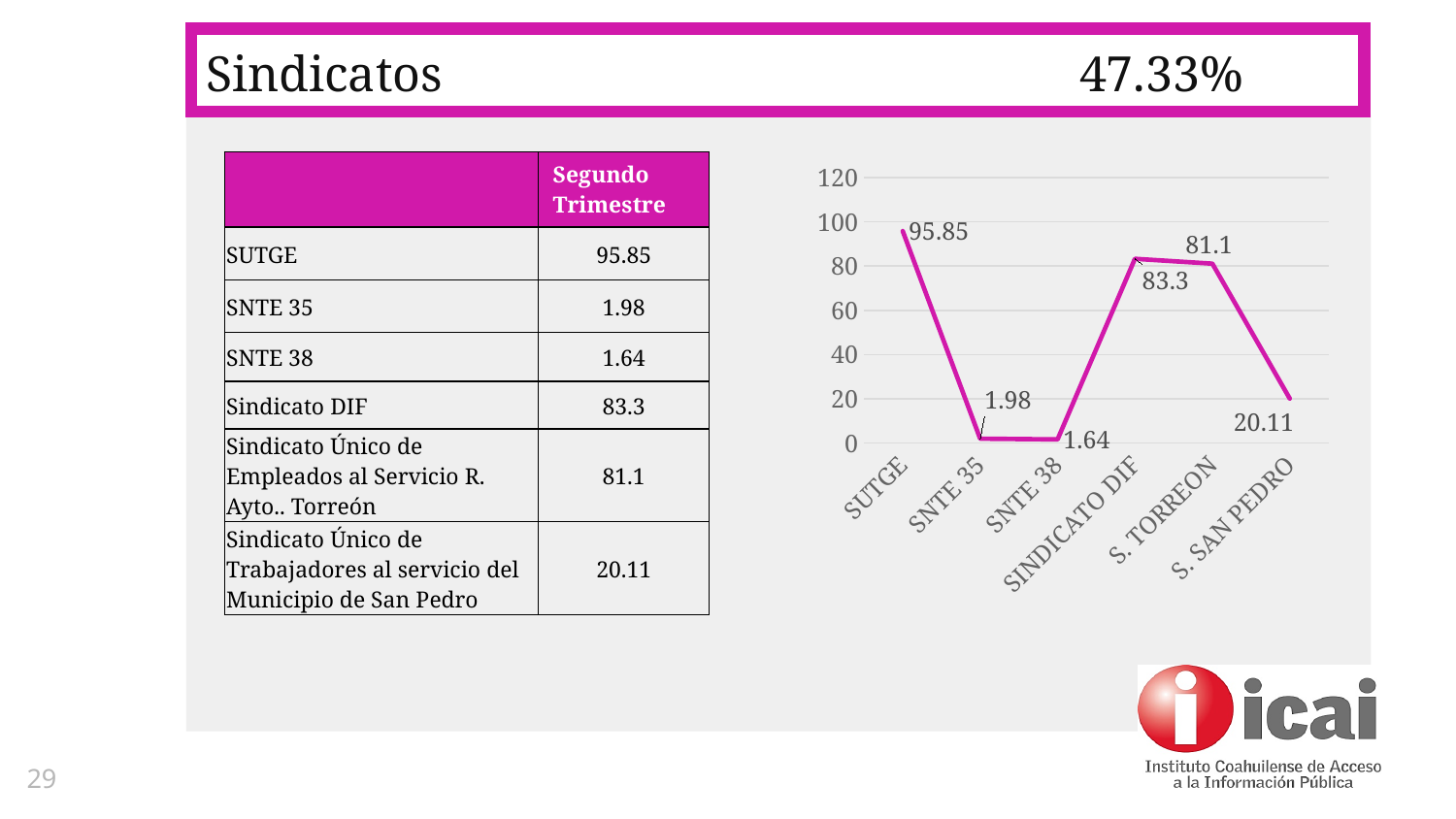
How many categories are plotted on the x axis of the chart? 6 Which category has the lowest value in the chart? SNTE 38 What type of chart is shown on the slide? line chart Is the value for S. TORREON in the chart greater or less than 60? greater What is the value plotted for S. SAN PEDRO in the chart? 20.11 What is the value plotted for SNTE 38 in the chart? 1.64 What is the value plotted for SINDICATO DIF in the chart? 83.3 What is the highest tick value shown on the vertical axis of the chart? 120 What is the difference between the values for SUTGE and S. SAN PEDRO in the chart? 75.74 Which category has the highest value in the chart? SUTGE What is the value plotted for SUTGE in the chart? 95.85 Which is larger in the chart, the value for SINDICATO DIF or the value for S. TORREON? SINDICATO DIF